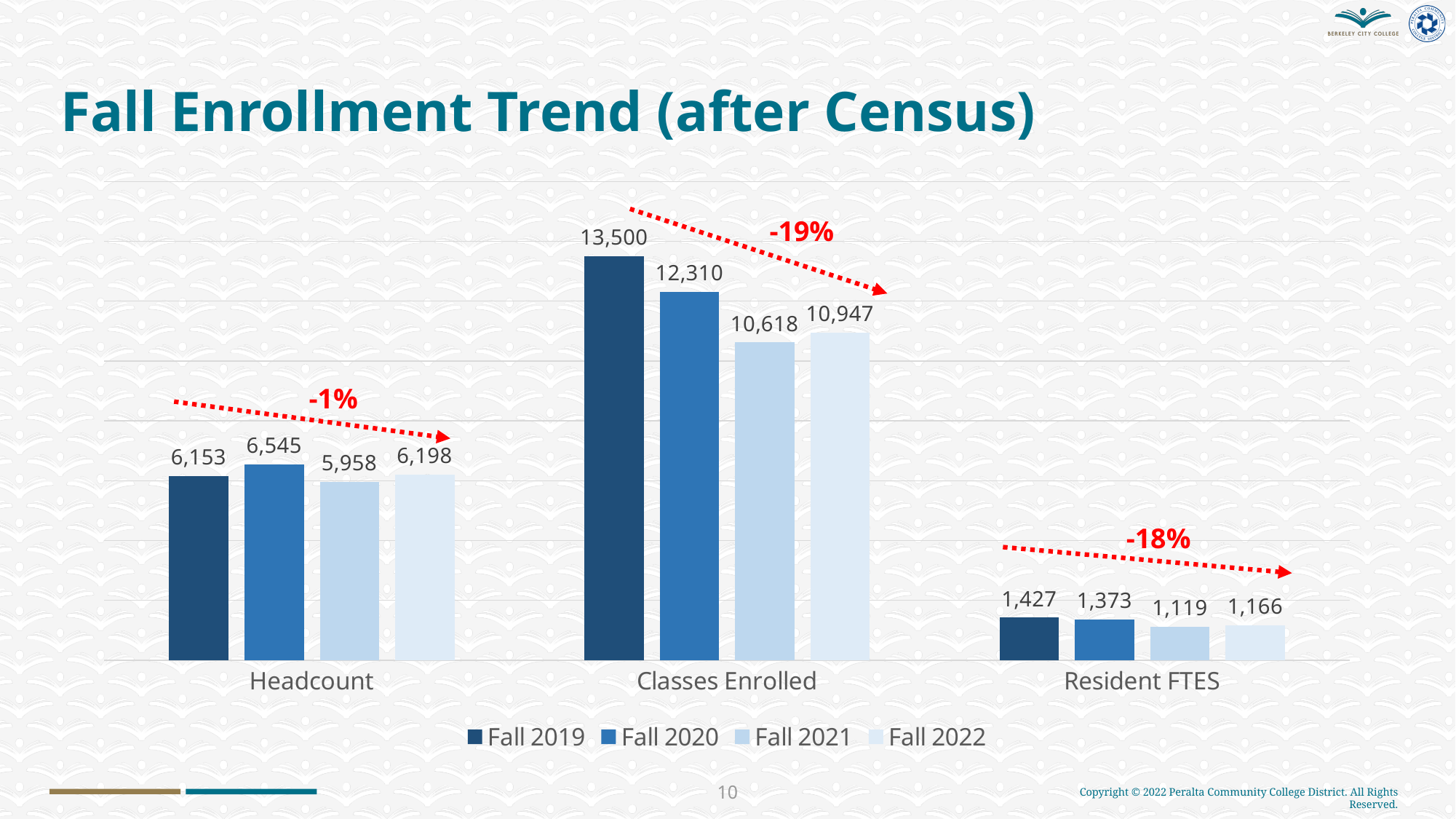
Which series has the lowest Headcount value? Fall 2021 What is the difference between the Classes Enrolled values for Fall 2019 and Fall 2022? 2,553 How many categories are shown on the x axis? 3 What is the difference between the Resident FTES values for Fall 2019 and Fall 2020? 54 Which series has the highest Classes Enrolled value? Fall 2019 What is the Resident FTES value for Fall 2021? 1,119 How many series does the legend list? 4 What is the Classes Enrolled value for Fall 2022? 10,947 What is the Headcount value for Fall 2020? 6,545 What percentage change is annotated above the Classes Enrolled bars? -19% What kind of chart is shown on the slide? Bar chart Which is larger, the Headcount for Fall 2019 or for Fall 2022? Fall 2022